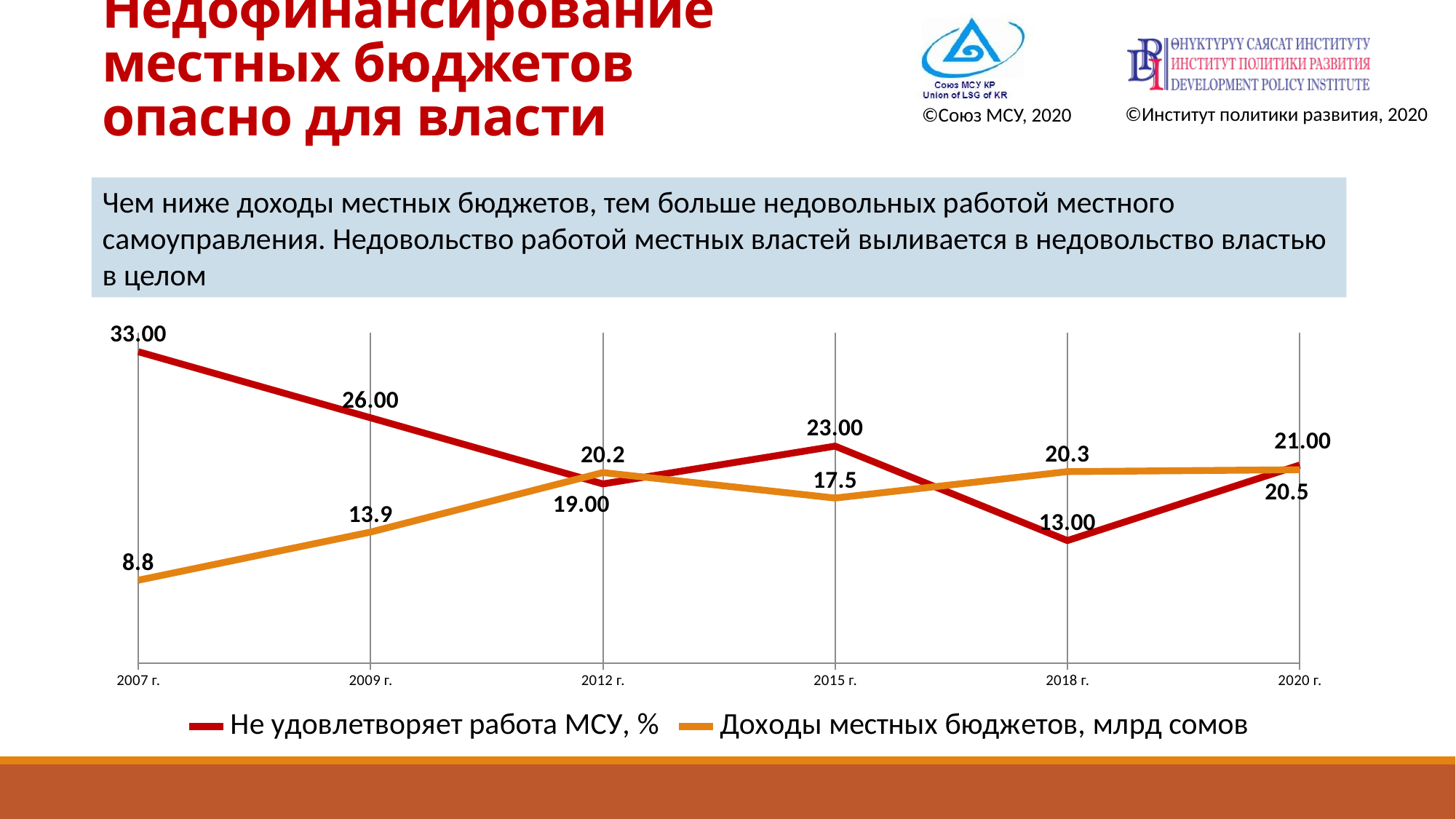
What is the value of "Не удовлетворяет работа МСУ, %" for 2018 г.? 13.00 What is the value of "Доходы местных бюджетов, млрд сомов" for 2009 г.? 13.9 How many years are plotted along the x axis of the chart? 6 What is the difference between the "Не удовлетворяет работа МСУ, %" values for 2007 г. and 2009 г.? 7.00 Which colour is used for the "Доходы местных бюджетов, млрд сомов" line? orange What type of chart is shown on the slide? line chart Which is larger in 2015 г.: "Не удовлетворяет работа МСУ, %" or "Доходы местных бюджетов, млрд сомов"? Не удовлетворяет работа МСУ, % Does "Доходы местных бюджетов, млрд сомов" generally rise or fall from 2007 г. to 2020 г.? rise In which year is "Не удовлетворяет работа МСУ, %" highest? 2007 г. How many series does the chart legend list? 2 What is the value of "Не удовлетворяет работа МСУ, %" for 2007 г.? 33.00 In which year is "Доходы местных бюджетов, млрд сомов" lowest? 2007 г.